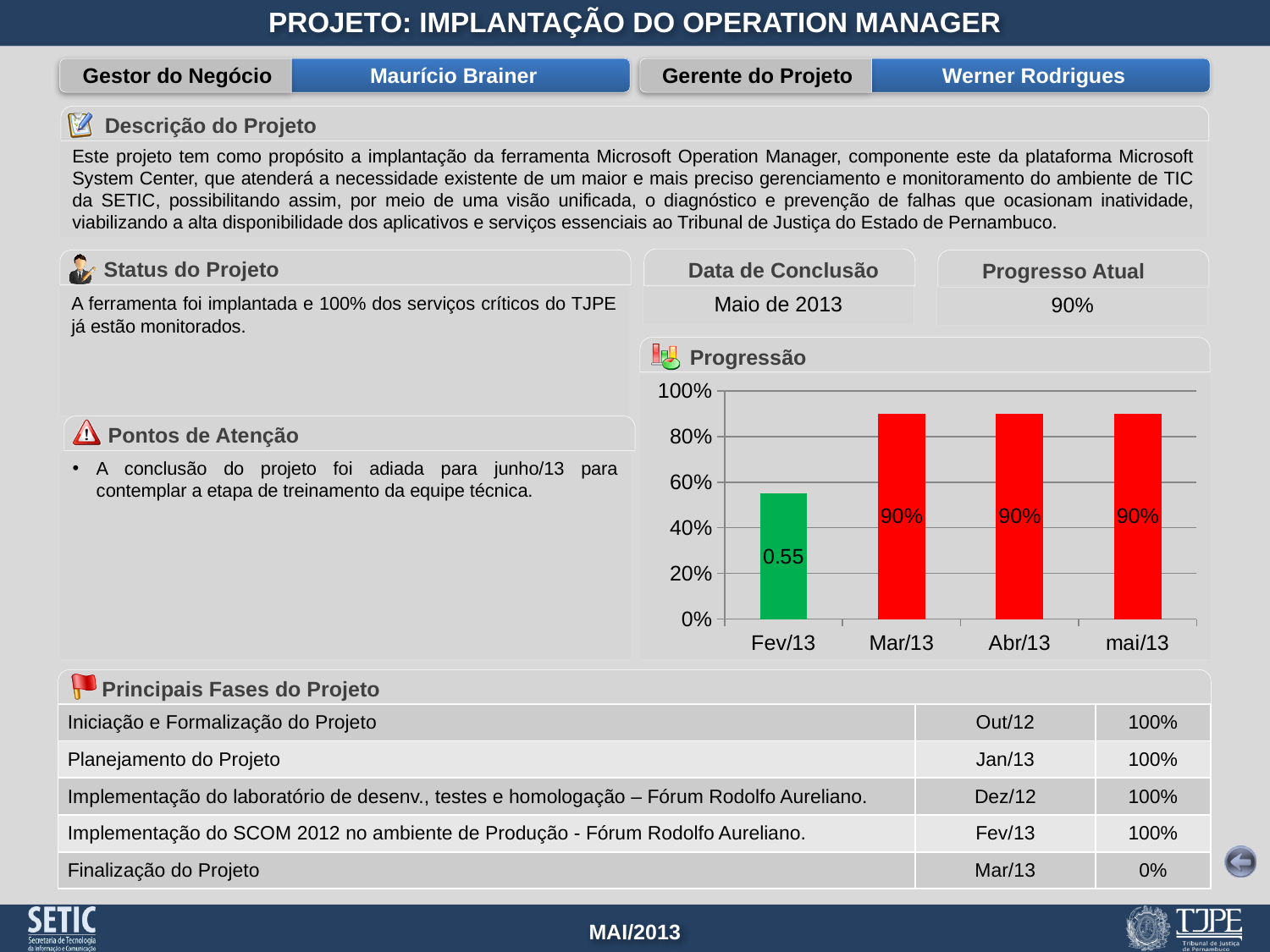
Do the values in the Progressão chart rise or fall from Fev/13 to Mar/13? rise What value is shown for Mar/13 in the Progressão chart? 90% What is the data label shown on the Fev/13 bar in the Progressão chart? 0.55 Is the value for Mar/13 in the Progressão chart greater or less than 80%? greater In the Progressão chart, which is larger, the value for Fev/13 or the value for Mar/13? Mar/13 Is the value for Fev/13 in the Progressão chart greater or less than 60%? less How many months are plotted on the x axis of the Progressão chart? 4 What colour is the Fev/13 bar in the Progressão chart? green What value is shown for Abr/13 in the Progressão chart? 90% What value is shown for mai/13 in the Progressão chart? 90% What kind of chart is the Progressão chart? bar chart Which month has the lowest bar in the Progressão chart? Fev/13